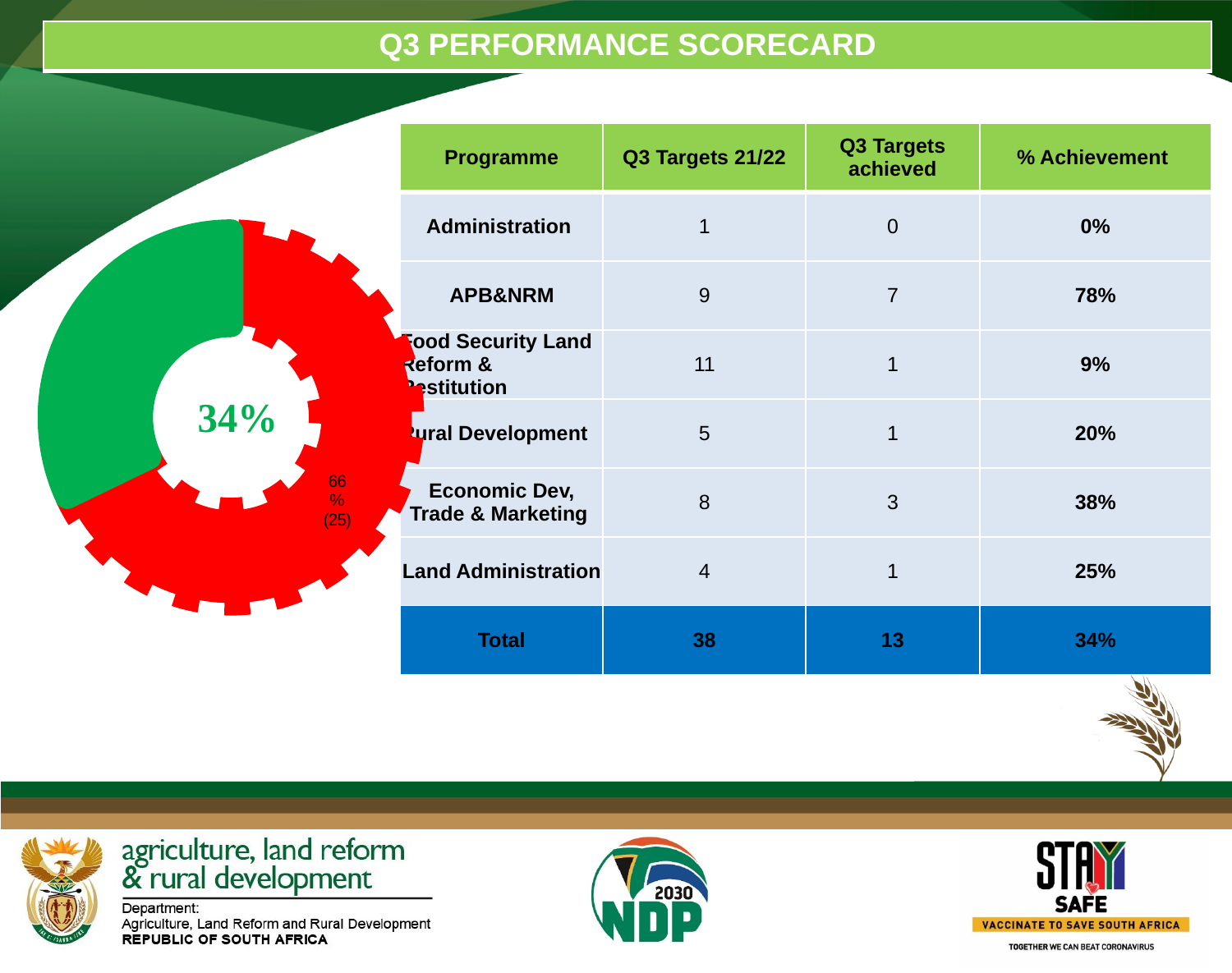
What colour is the slice of the doughnut chart labelled 34%? green Which slice of the doughnut chart is the largest? the red slice (66%) What percentage is printed in the centre of the doughnut chart? 34% Is the green slice of the doughnut chart greater or less than 50% of the whole? less What is the difference in percentage points between the red slice (66%) and the green slice (34%) of the doughnut chart? 32 percentage points What kind of chart is shown on the left of the slide? doughnut chart What number appears in parentheses under the 66% label on the doughnut chart? 25 Is the red slice or the green slice of the doughnut chart larger? the red slice What percentage is labelled on the red slice of the doughnut chart? 66% Which slice of the doughnut chart is the smallest? the green slice (34%) How many slices does the doughnut chart have? 2 What share of the doughnut chart does the red slice represent? 66%